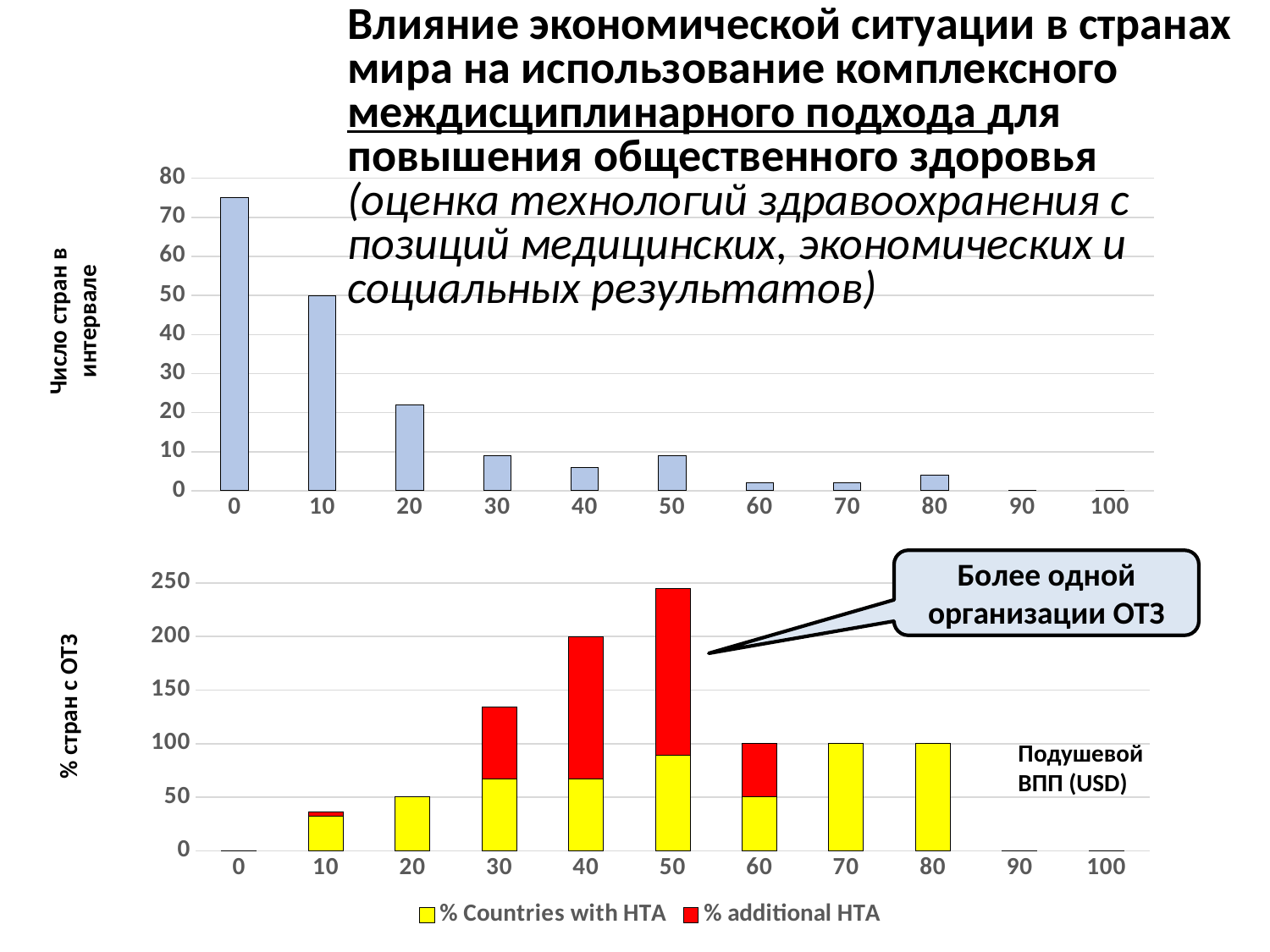
In the top chart (Число стран в интервале), which x-axis category has the highest bar? 0 In the bottom chart (% стран с ОТЗ), is the total of the stacked bar for category 50 greater or less than 200? greater In the bottom chart (% стран с ОТЗ), which x-axis category has the tallest stacked bar? 50 In the top chart (Число стран в интервале), do the bar values generally rise or fall from category 0 to category 100? fall In the bottom chart (% стран с ОТЗ), is the stacked bar for category 50 taller than the stacked bar for category 40? yes How many series does the legend of the bottom chart (% стран с ОТЗ) list? 2 How many x-axis categories does the top chart (Число стран в интервале) show? 11 In the bottom chart (% стран с ОТЗ), what colour represents the series '% additional HTA'? red In the top chart (Число стран в интервале), is the value for category 10 greater or less than 40? greater In the top chart (Число стран в интервале), is the value for category 0 greater or less than 70? greater What kind of chart is the top chart (Число стран в интервале)? bar chart